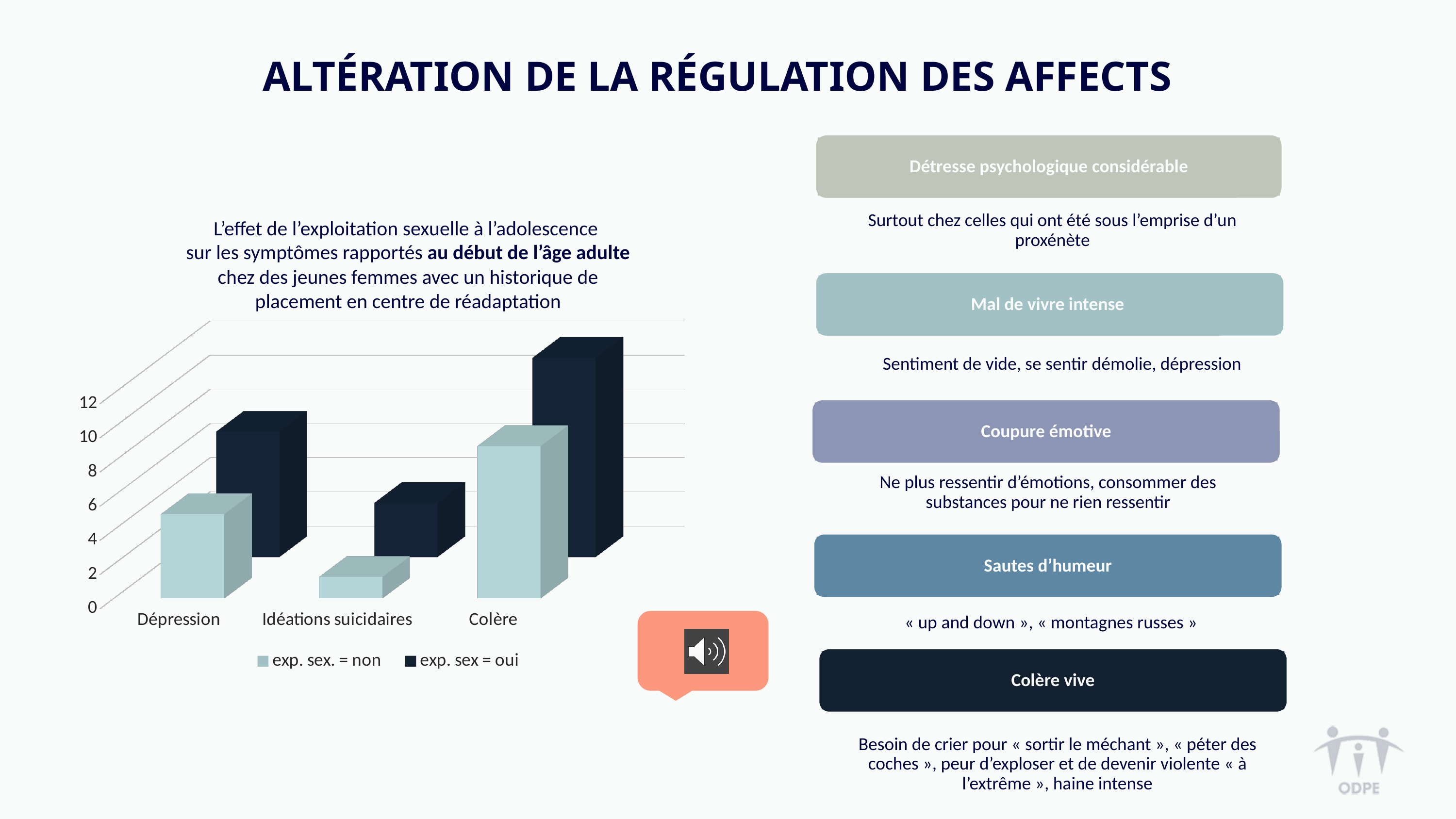
Which series is shown in dark navy in the chart legend? exp. sex = oui What is the highest tick value shown on the chart's vertical axis? 12 Which category has the highest value for the series "exp. sex. = non"? Colère Is the value for Idéations suicidaires in the series "exp. sex. = non" greater or less than 4? less Which category has the lowest value for the series "exp. sex. = non"? Idéations suicidaires How many categories are shown on the x axis of the chart? 3 Which category has the highest value for the series "exp. sex = oui"? Colère What kind of chart is shown on the slide? bar chart For Dépression, which series has the larger value: "exp. sex. = non" or "exp. sex = oui"? exp. sex = oui How many series does the chart legend list? 2